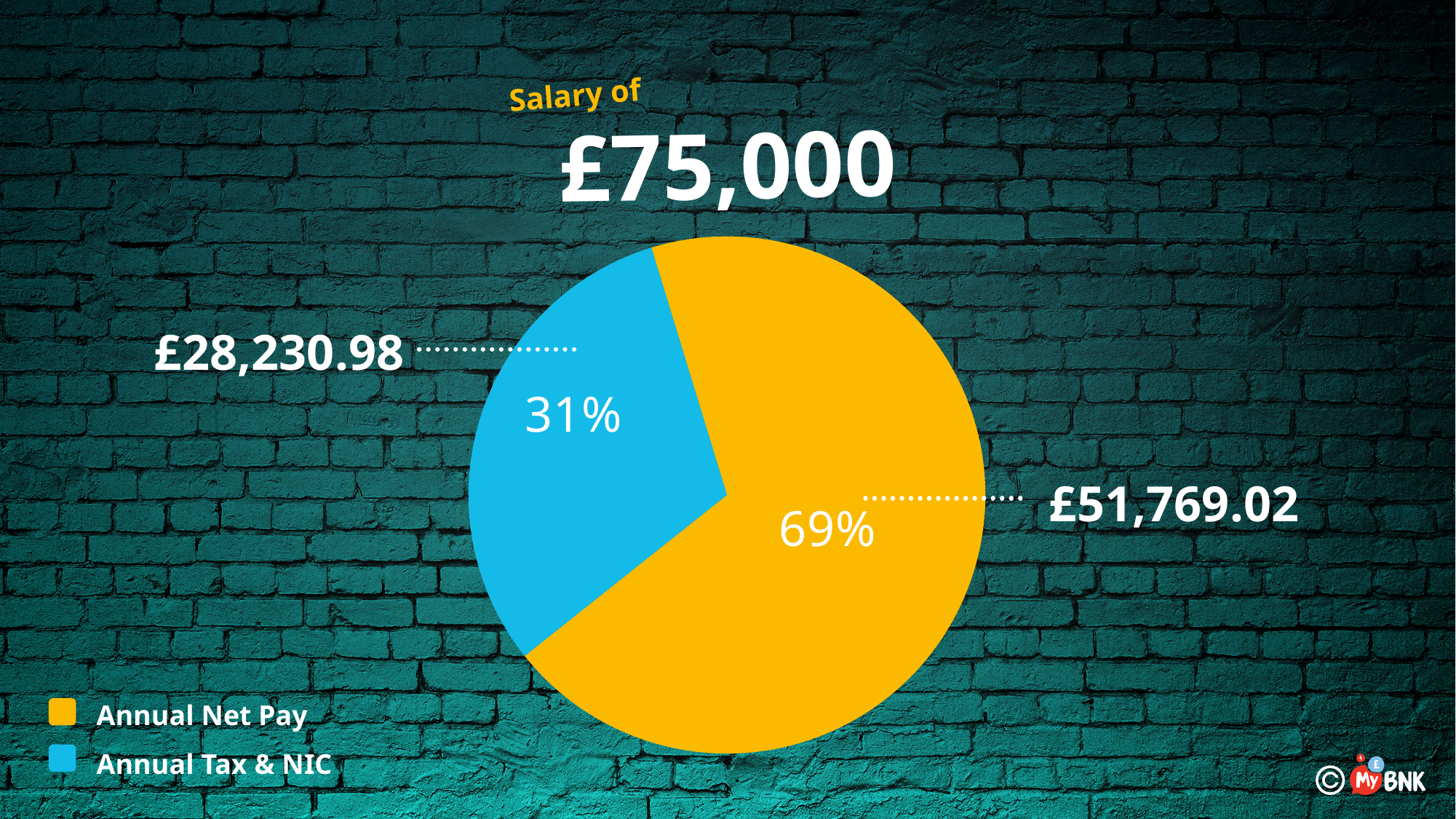
What kind of chart is shown on the slide? pie chart What is the value for Annual Net Pay? £51,769.02 Which slice is the smallest? Annual Tax & NIC Which slice is the largest? Annual Net Pay What share of the pie does Annual Tax & NIC represent? 31% How many slices does the pie chart have? 2 How many entries does the legend list? 2 What is the difference between Annual Net Pay and Annual Tax & NIC? £23,538.04 What is the value for Annual Tax & NIC? £28,230.98 What salary is the pie chart based on, according to the title? £75,000 Which is larger, Annual Net Pay or Annual Tax & NIC? Annual Net Pay What share of the pie does Annual Net Pay represent? 69%